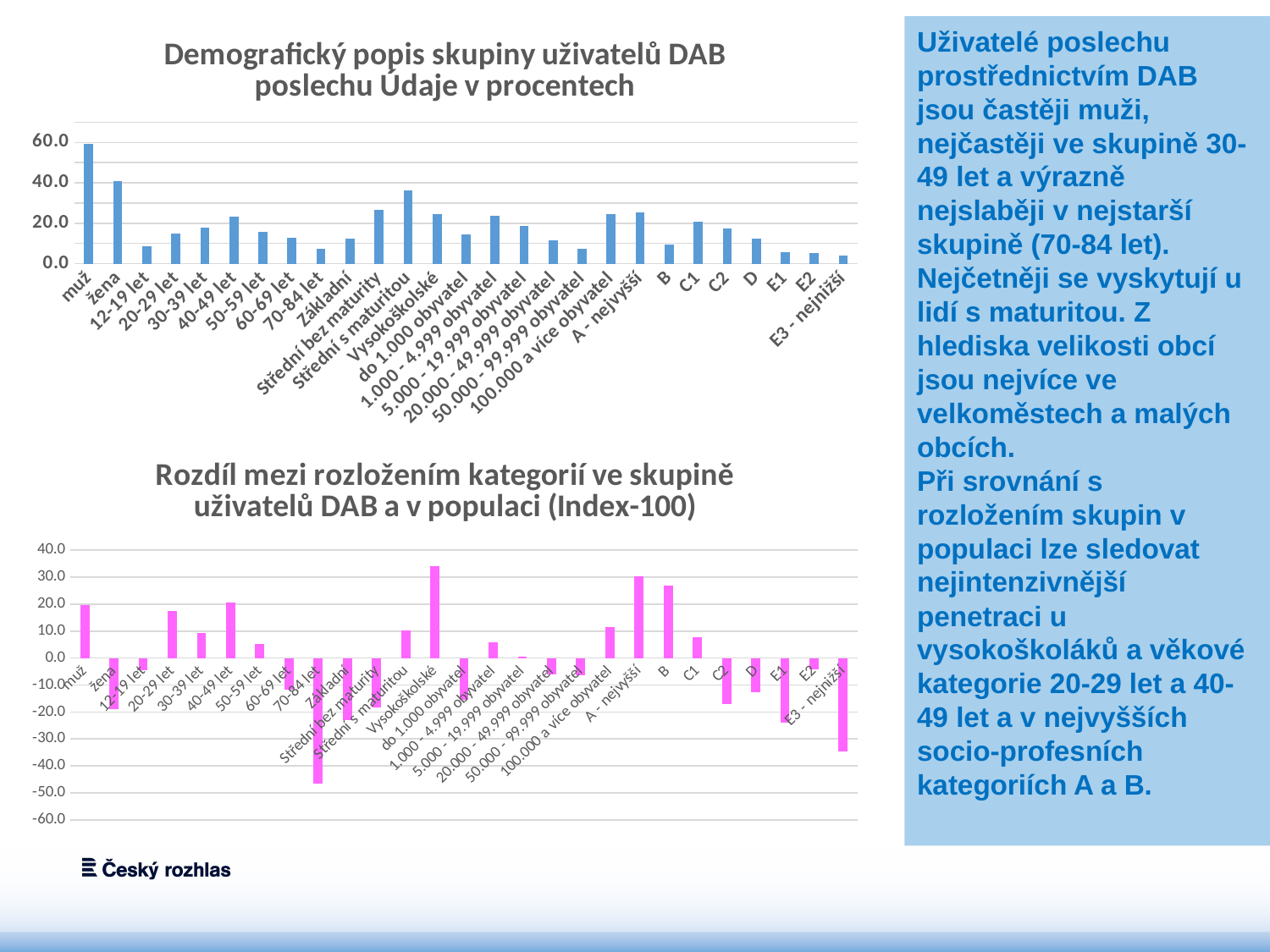
In the bottom chart (Rozdíl mezi rozložením kategorií ve skupině uživatelů DAB a v populaci), which category has the lowest value? 70-84 let What colour are the bars in the bottom chart (Rozdíl mezi rozložením kategorií ve skupině uživatelů DAB a v populaci)? pink In the top chart (Demografický popis skupiny uživatelů DAB poslechu), which category has the highest value? muž In the bottom chart (Rozdíl mezi rozložením kategorií ve skupině uživatelů DAB a v populaci), which category has the highest value? Vysokoškolské In the bottom chart (Rozdíl mezi rozložením kategorií ve skupině uživatelů DAB a v populaci), is the value for 70-84 let greater or less than -40.0? less What kind of chart is the top chart titled 'Demografický popis skupiny uživatelů DAB poslechu'? bar chart In the top chart (Demografický popis skupiny uživatelů DAB poslechu), is the value for muž greater or less than 40.0? greater How many categories are plotted in the top chart (Demografický popis skupiny uživatelů DAB poslechu)? 27 In the top chart (Demografický popis skupiny uživatelů DAB poslechu), which is larger, the value for muž or the value for žena? muž In the top chart (Demografický popis skupiny uživatelů DAB poslechu), which is larger, the value for 40-49 let or the value for 70-84 let? 40-49 let In the bottom chart (Rozdíl mezi rozložením kategorií ve skupině uživatelů DAB a v populaci), is the value for E3 - nejnižší greater or less than -30.0? less